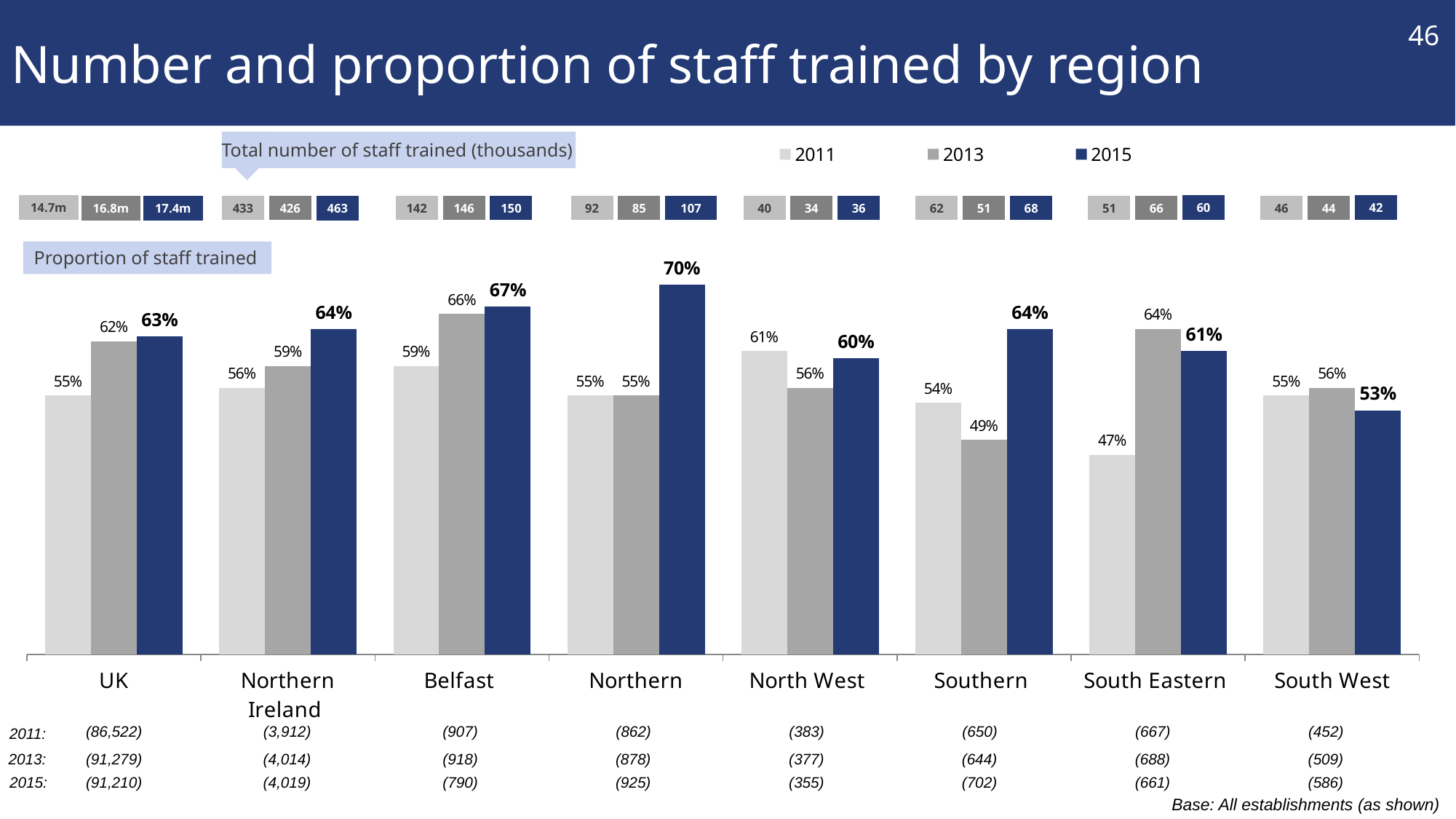
Which region has the lowest proportion of staff trained in 2011? South Eastern Which is larger: the 2013 proportion of staff trained in South Eastern or in Southern? South Eastern What kind of chart is used to show the proportion of staff trained? Bar chart What is the difference between the 2015 and 2011 proportion of staff trained in Northern? 15 percentage points Which region has the highest proportion of staff trained in 2015? Northern What is the proportion of staff trained in Belfast in 2013? 66% How many series does the legend list? 3 How many regions (categories) are shown on the x axis of the chart? 8 Does the proportion of staff trained in Southern rise or fall from 2013 to 2015? Rise What is the proportion of staff trained in Northern in 2015? 70% What is the proportion of staff trained in South Eastern in 2011? 47% What is the total number of staff trained (thousands) in Belfast in 2015? 150